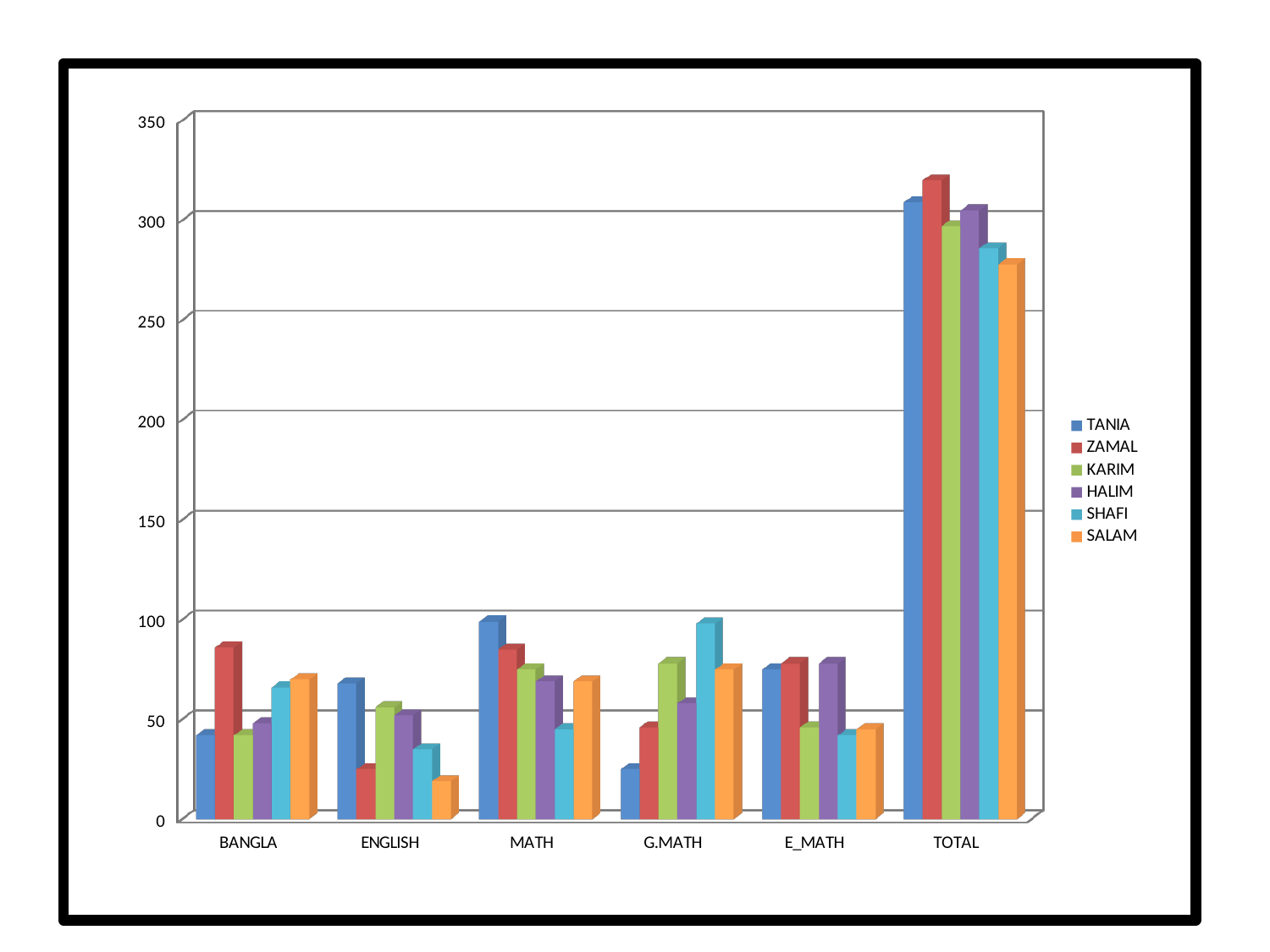
What kind of chart is shown on the slide? bar chart How many categories are shown along the x axis? 6 Which series has the highest value in the G.MATH category? SHAFI Which series is shown in orange in the legend? SALAM Is the value for ZAMAL in the ENGLISH category greater or less than 50? less In the BANGLA category, which is larger, the value for TANIA or the value for ZAMAL? ZAMAL Is the value for ZAMAL in the TOTAL category greater or less than 300? greater Which series has the highest value in the MATH category? TANIA Which series has the highest value in the BANGLA category? ZAMAL Which series has the lowest value in the G.MATH category? TANIA How many series does the legend list? 6